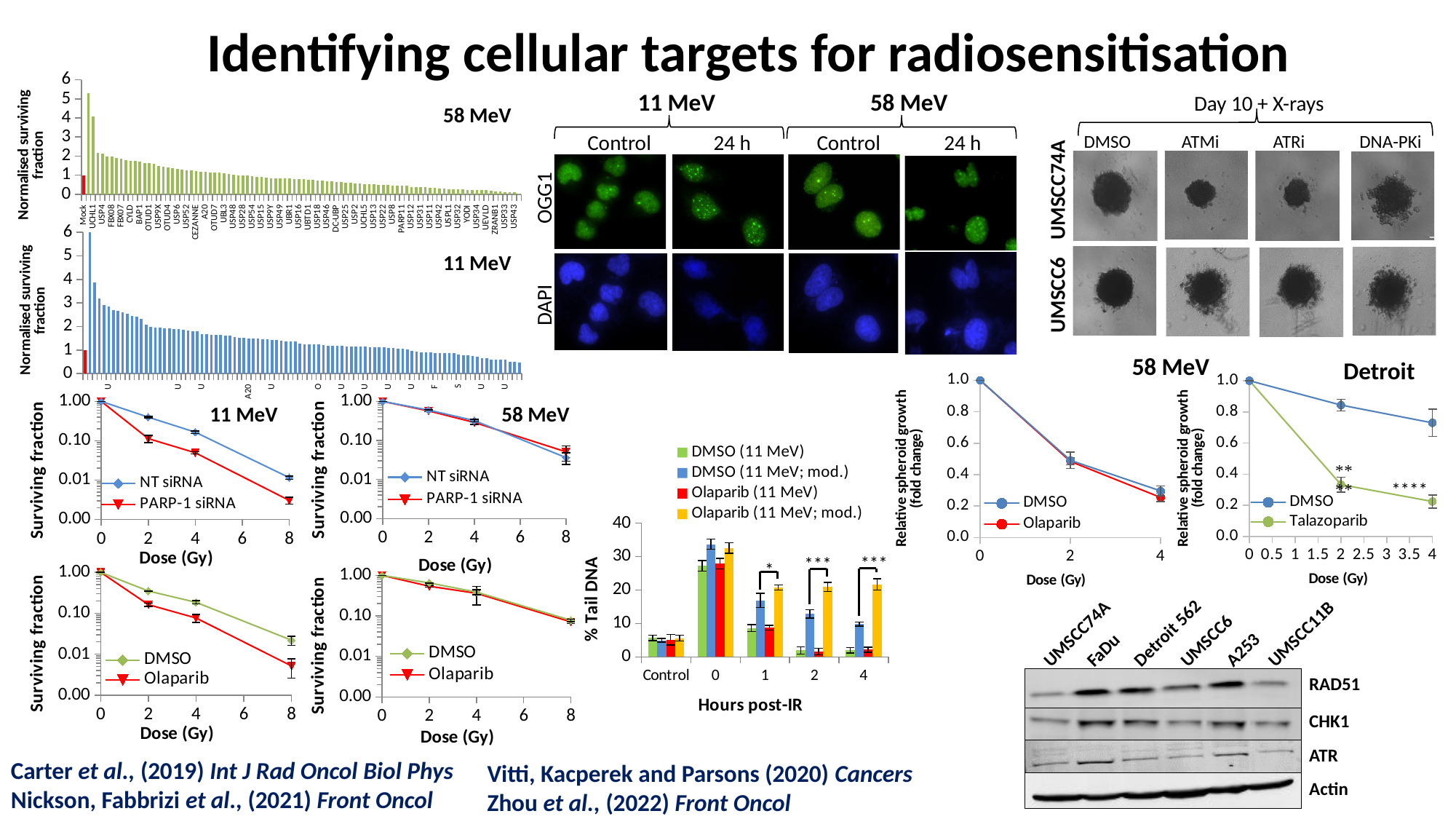
In the % Tail DNA bar chart, how many series does the legend list? 4 In the 11 MeV surviving fraction line chart with NT siRNA and PARP-1 siRNA, which series has the lower value at 8 Gy? PARP-1 siRNA What kind of chart is the % Tail DNA chart? bar chart In the 58 MeV relative spheroid growth chart, is the DMSO value at 2 Gy greater or less than 0.6? less In the Detroit relative spheroid growth chart, is the Talazoparib value at 4 Gy greater or less than 0.4? less In the % Tail DNA chart, at 2 hours post-IR, which is larger: DMSO (11 MeV; mod.) or Olaparib (11 MeV; mod.)? Olaparib (11 MeV; mod.) In the % Tail DNA chart, how many categories are shown on the Hours post-IR axis? 5 In the 58 MeV relative spheroid growth chart, do the DMSO values rise or fall as dose increases? fall In the Detroit relative spheroid growth chart, which series has the larger value at 2 Gy, DMSO or Talazoparib? DMSO In the % Tail DNA chart, at which hours post-IR category is the DMSO (11 MeV; mod.) value highest? 0 In the % Tail DNA chart, is the value for Olaparib (11 MeV; mod.) at 4 hours post-IR greater or less than 10? greater